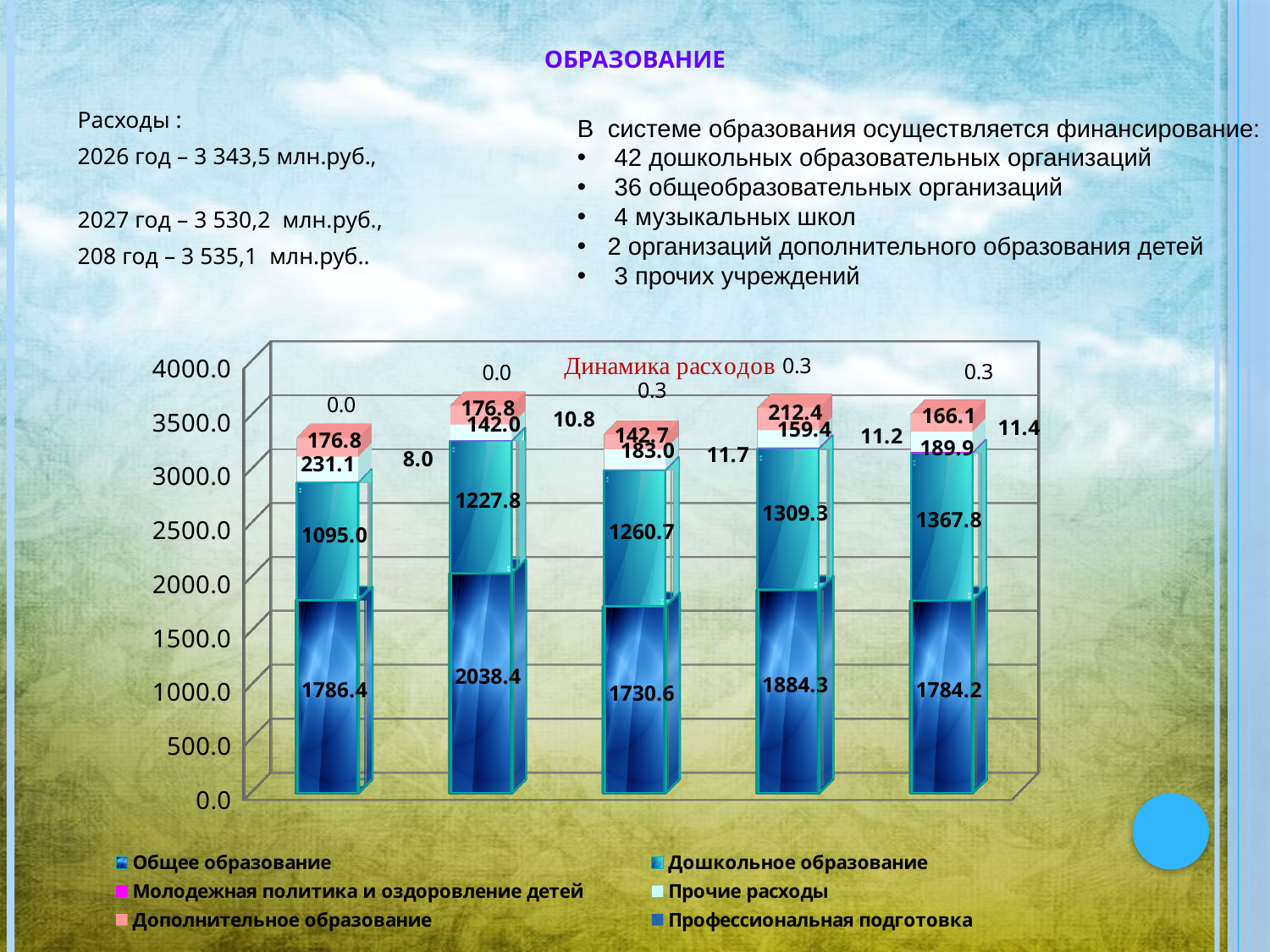
What is the value of the Дошкольное образование segment in the second bar? 1227.8 Which bar has the highest Общее образование value? The second bar (2038.4) What is the value of the Общее образование segment in the first (leftmost) bar? 1786.4 What is the value of the Дошкольное образование segment in the fifth (rightmost) bar? 1367.8 Do the Дошкольное образование values rise or fall from the first bar to the fifth bar? Rise What is the difference between the Общее образование values of the second bar and the third bar? 307.8 How many series does the chart legend list? 6 Which bar has the lowest Общее образование value? The third bar (1730.6) Which is larger: the Дошкольное образование value in the fourth bar or in the fifth bar? The fifth bar (1367.8) How many stacked bars are plotted in the chart? 5 What is the title of the chart? Динамика расходов What kind of chart is shown on the slide? Stacked bar chart